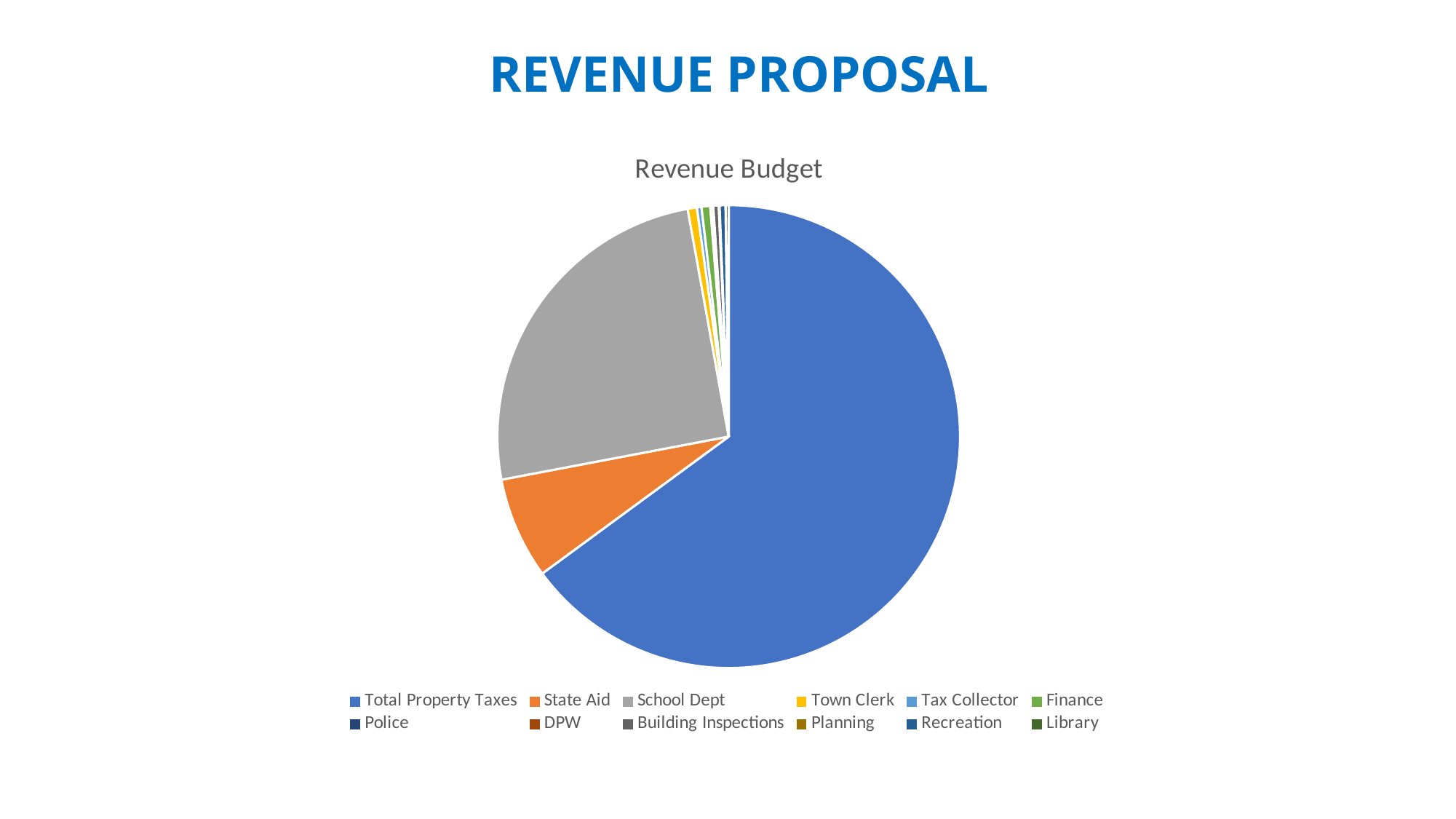
Is the State Aid slice greater or less than 25% of the Revenue Budget pie? less Which slice is larger in the Revenue Budget pie chart, State Aid or Town Clerk? State Aid What colour is the Total Property Taxes slice in the Revenue Budget pie chart? Blue Which category has the largest slice in the Revenue Budget pie chart? Total Property Taxes What kind of chart is shown on the slide? Pie chart Which slice is larger in the Revenue Budget pie chart, Total Property Taxes or School Dept? Total Property Taxes What is the title of the chart? Revenue Budget Which category is the second largest slice in the Revenue Budget pie chart? School Dept Is the Total Property Taxes slice greater or less than 50% of the Revenue Budget pie? greater How many categories does the legend of the Revenue Budget pie chart list? 12 Which slice is larger in the Revenue Budget pie chart, School Dept or State Aid? School Dept